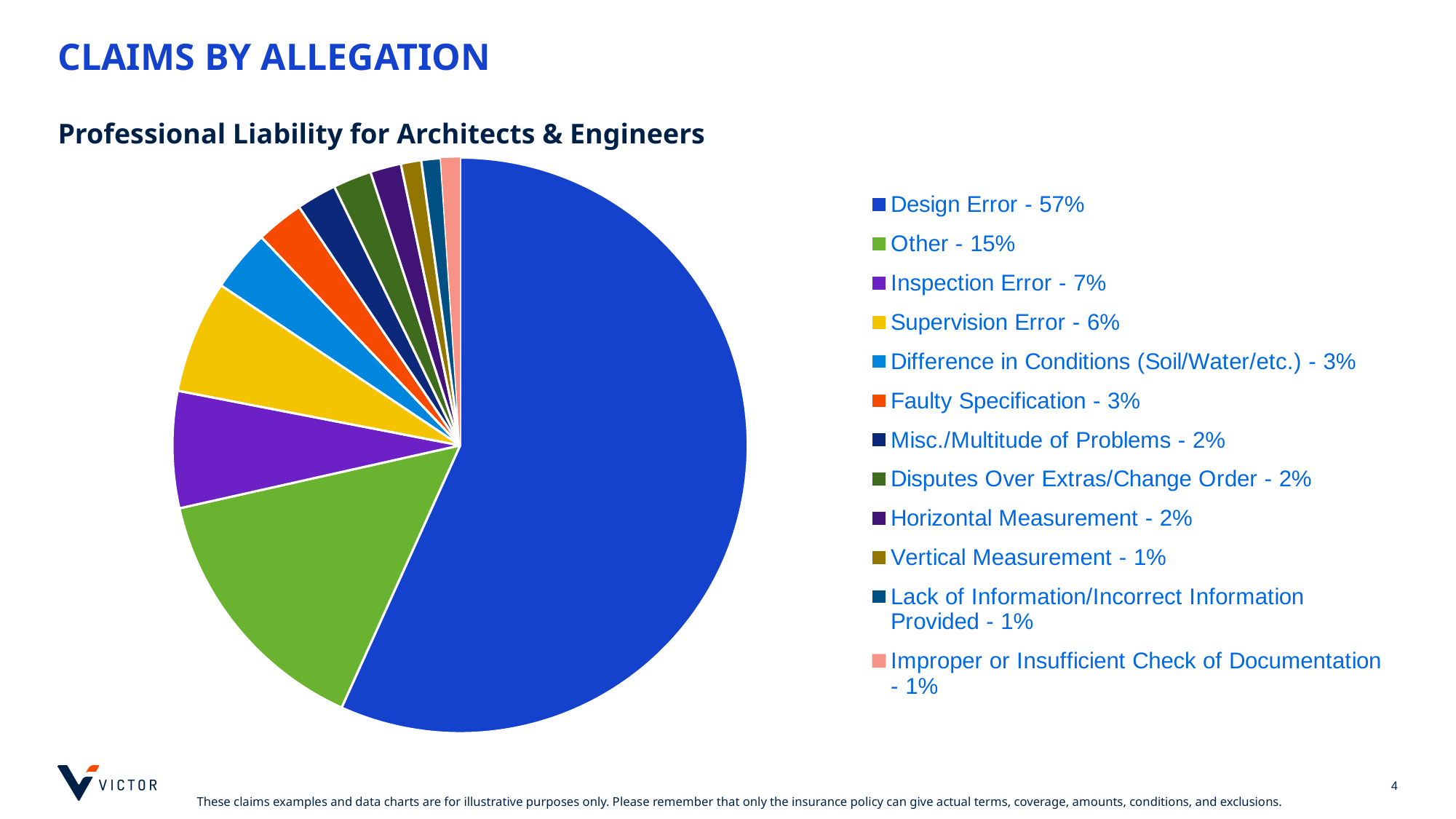
What is the subtitle shown above the pie chart? Professional Liability for Architects & Engineers How many allegation categories does the legend list? 12 Which has a larger share of claims, Inspection Error or Supervision Error? Inspection Error What share of claims is attributed to Faulty Specification? 3% Which allegation category has the largest share of claims? Design Error What share of claims is attributed to Supervision Error? 6% What is the combined share of Design Error and Other? 72% What share of claims is attributed to Inspection Error? 7% What is the difference in percentage points between Design Error and Other? 42 What kind of chart is shown on the slide? pie chart